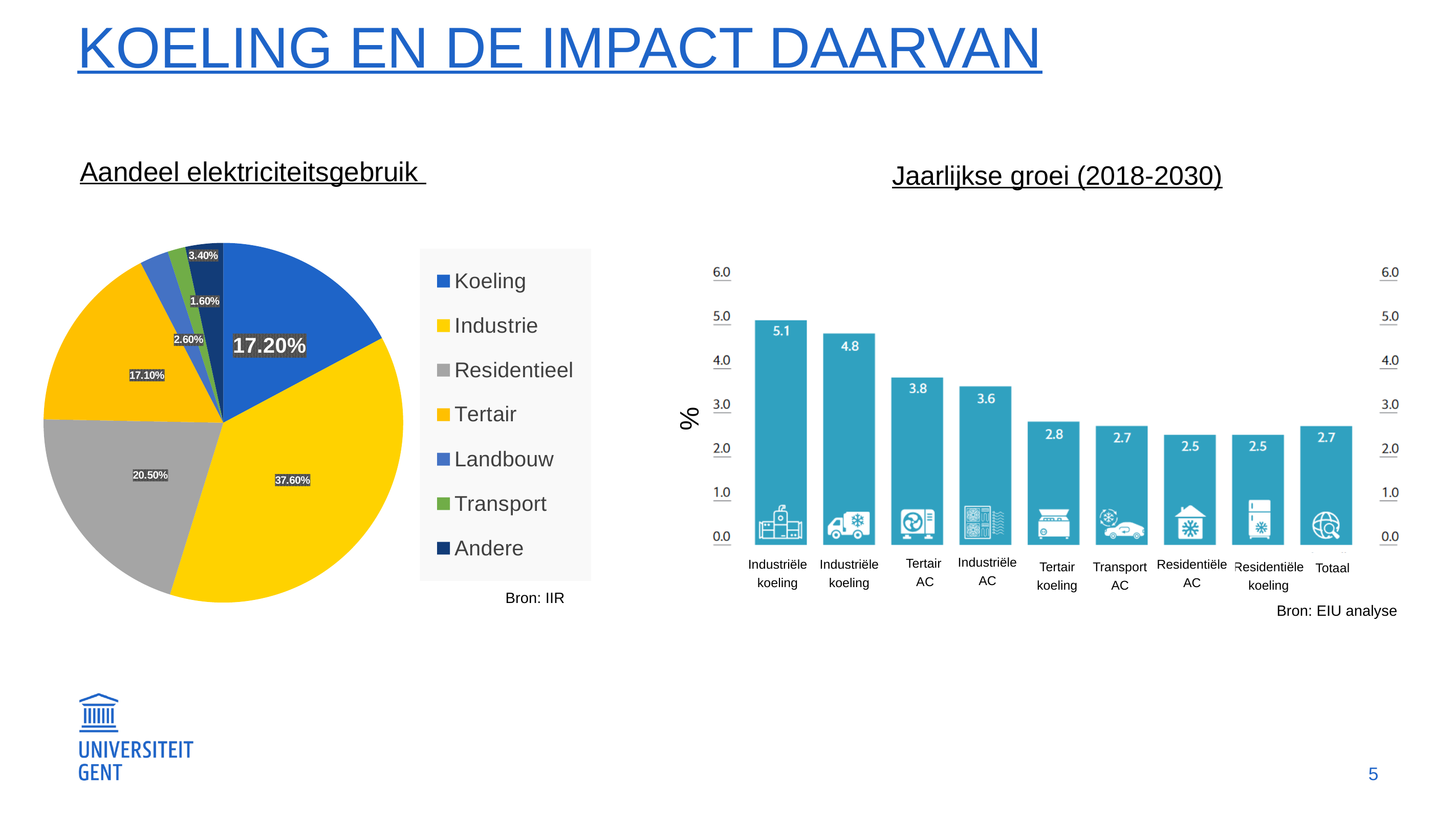
In the bar chart 'Jaarlijkse groei (2018-2030)', which is larger: Tertair AC or Industriële AC? Tertair AC In the pie chart 'Aandeel elektriciteitsgebruik', what share does Industrie have? 37.60% In the pie chart 'Aandeel elektriciteitsgebruik', what share does Koeling have? 17.20% In the pie chart 'Aandeel elektriciteitsgebruik', which category has the smallest share? Transport In the pie chart 'Aandeel elektriciteitsgebruik', how many categories does the legend list? 7 In the pie chart 'Aandeel elektriciteitsgebruik', how much larger is the share of Residentieel than that of Tertair? 3.40% In the bar chart 'Jaarlijkse groei (2018-2030)', what is the value for Tertair AC? 3.8 In the bar chart 'Jaarlijkse groei (2018-2030)', what is the value for Totaal? 2.7 In the bar chart 'Jaarlijkse groei (2018-2030)', how many bars are shown? 9 What kind of chart is 'Aandeel elektriciteitsgebruik'? Pie chart In the pie chart 'Aandeel elektriciteitsgebruik', which category has the largest share? Industrie In the bar chart 'Jaarlijkse groei (2018-2030)', is the value for Tertair koeling greater or less than 3.0? less